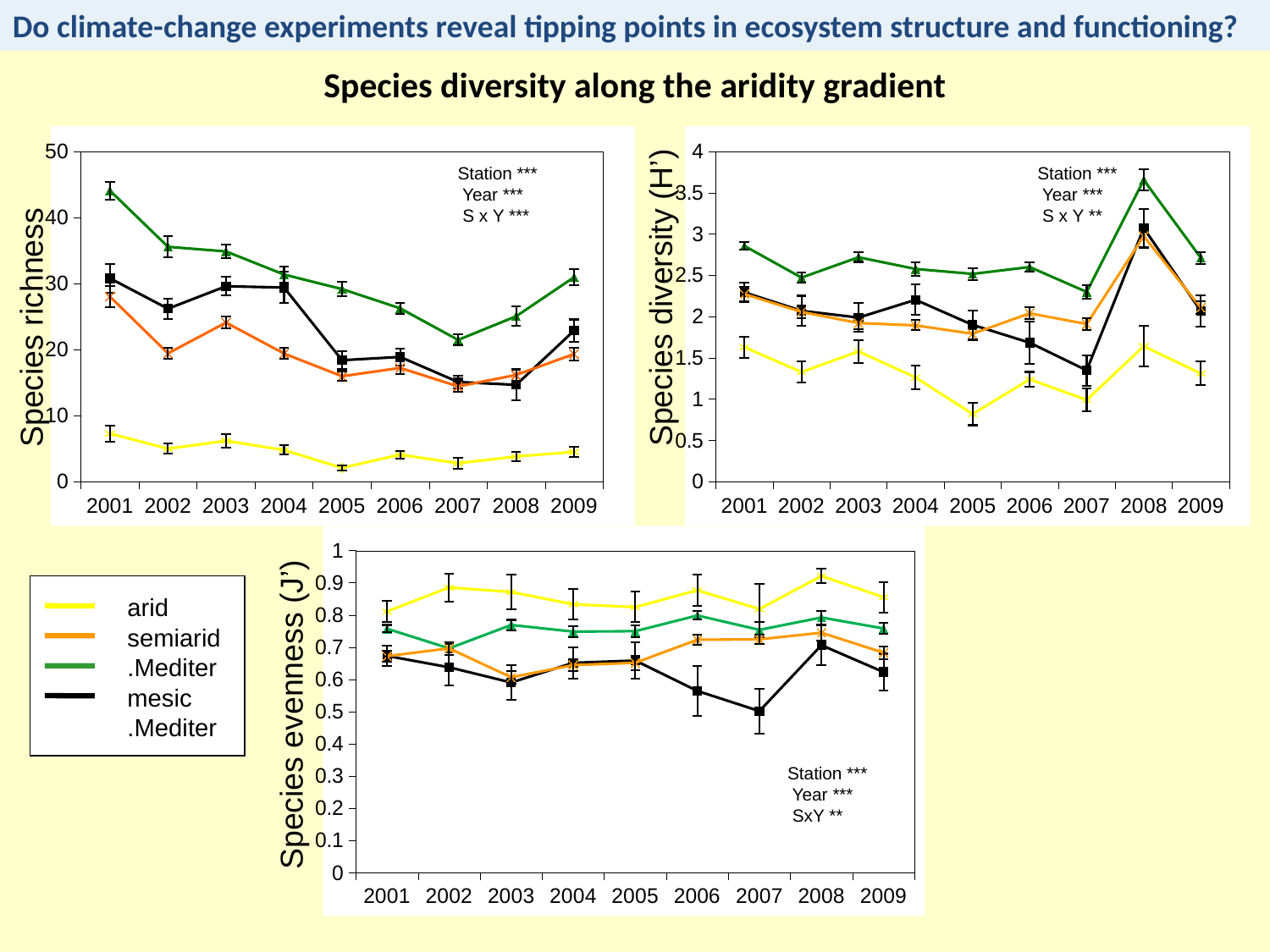
In the Species richness chart, does the .Mediter series rise or fall from 2001 to 2007? fall How many series does the legend list? 4 In the Species richness chart, which series has the highest value in 2001? .Mediter In the Species evenness (J') chart, which series has the highest value in 2008? arid In the Species richness chart, which series has the lowest values across all years? arid In the Species richness chart, is the value for .Mediter in 2001 greater or less than 40? greater In the Species diversity (H') chart, which is larger in 2008: .Mediter or arid? .Mediter In the Species evenness (J') chart, which series has the lowest value in 2007? mesic .Mediter How many years are plotted along the x axis of the Species richness chart? 9 What is the y-axis label of the bottom chart? Species evenness (J') What kind of chart is the Species richness chart? line chart In the Species richness chart, is the value for arid in 2005 greater or less than 10? less